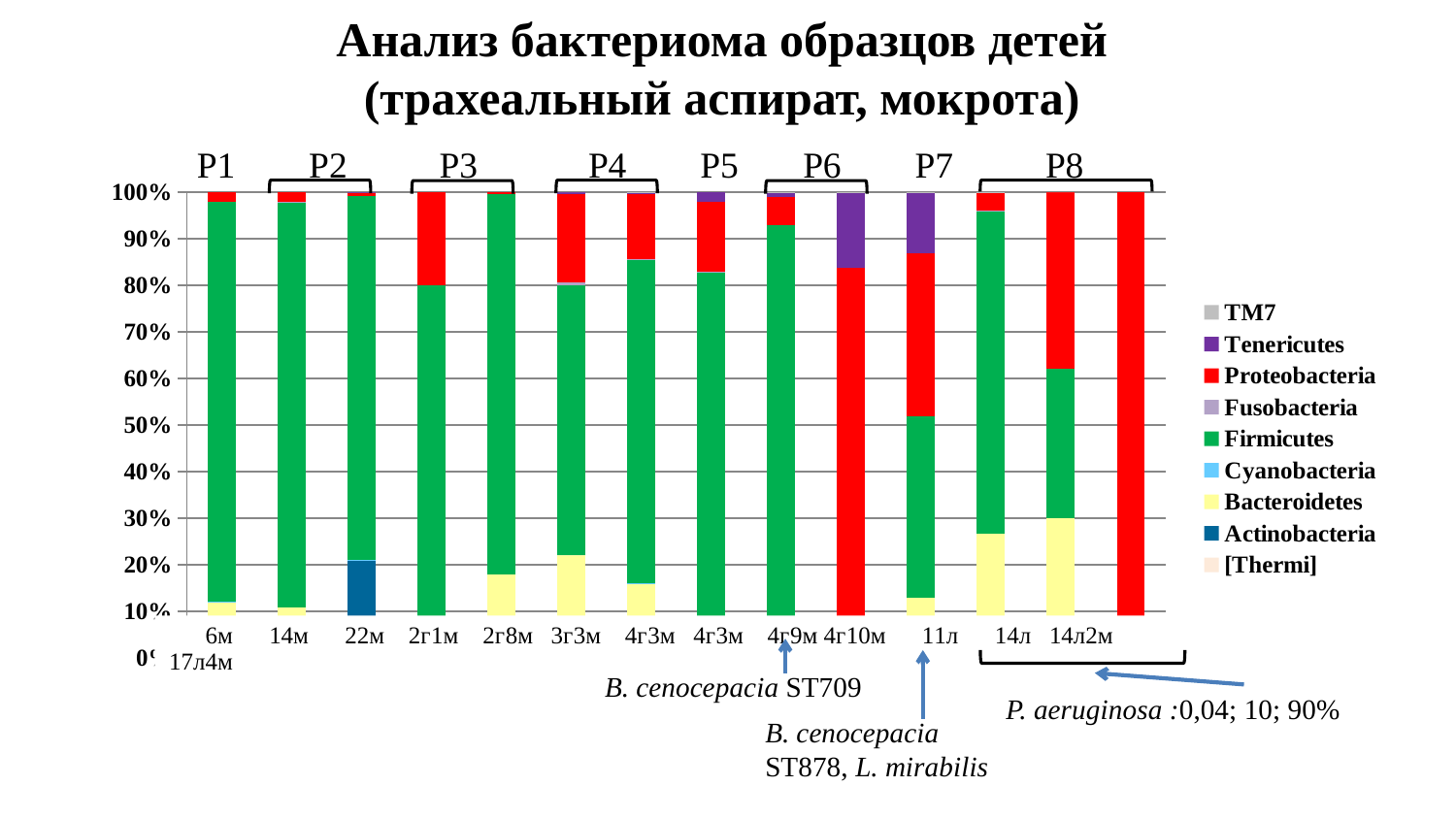
Which patient group label (P1–P8) spans three bars? P8 Is the top of the Firmicutes segment for 14л2м greater or less than 50%? greater Which bar has a larger Firmicutes share, 14м or 11л? 14м Which bar has the largest Proteobacteria share? 17л4м What colour represents Proteobacteria in the legend? red Is the top of the Firmicutes segment for 11л greater or less than 60%? less What kind of chart is shown on the slide? stacked bar chart Which bar has a larger Proteobacteria share, 17л4м or 6м? 17л4м Is the top of the Bacteroidetes segment for 14л2м greater or less than 20%? greater Which bar is the only one containing an Actinobacteria segment? 22м How many series does the legend list? 9 How many bars (samples) are plotted in the chart? 14